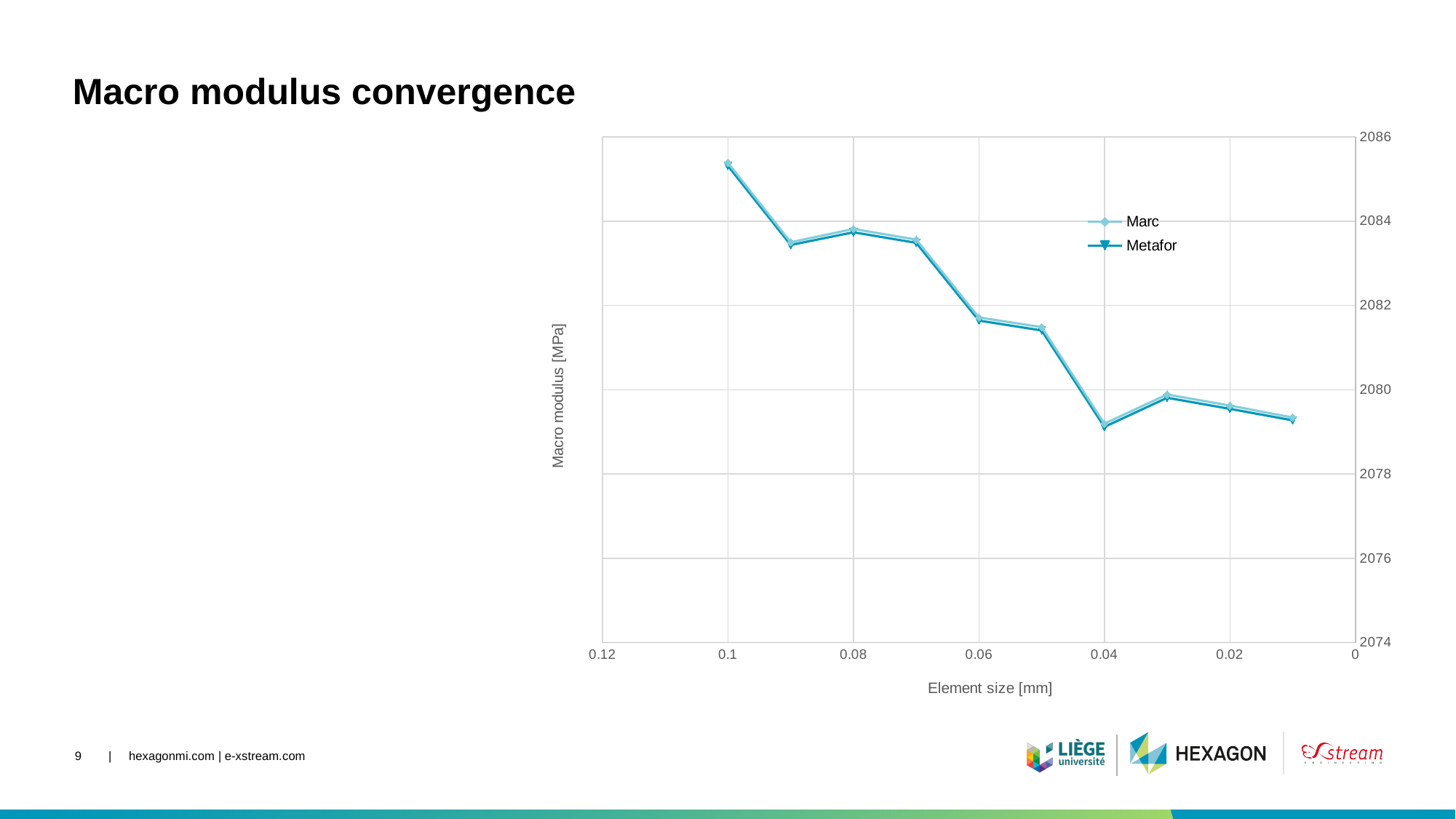
Is the Metafor value at element size 0.04 greater or less than 2080? less What is the title of the y axis? Macro modulus [MPa] Is the Marc value at element size 0.1 greater or less than 2084? greater How many series does the legend list? 2 At which element size is the Marc macro modulus highest? 0.1 What are the names of the two series in the legend? Marc and Metafor Do the macro modulus values generally rise or fall moving from left to right along the x axis? fall At which element size is the Metafor macro modulus lowest? 0.04 Is the Metafor value at element size 0.01 greater or less than 2078? greater What kind of chart is shown on the slide? line chart How many data points are plotted for the Marc series? 10